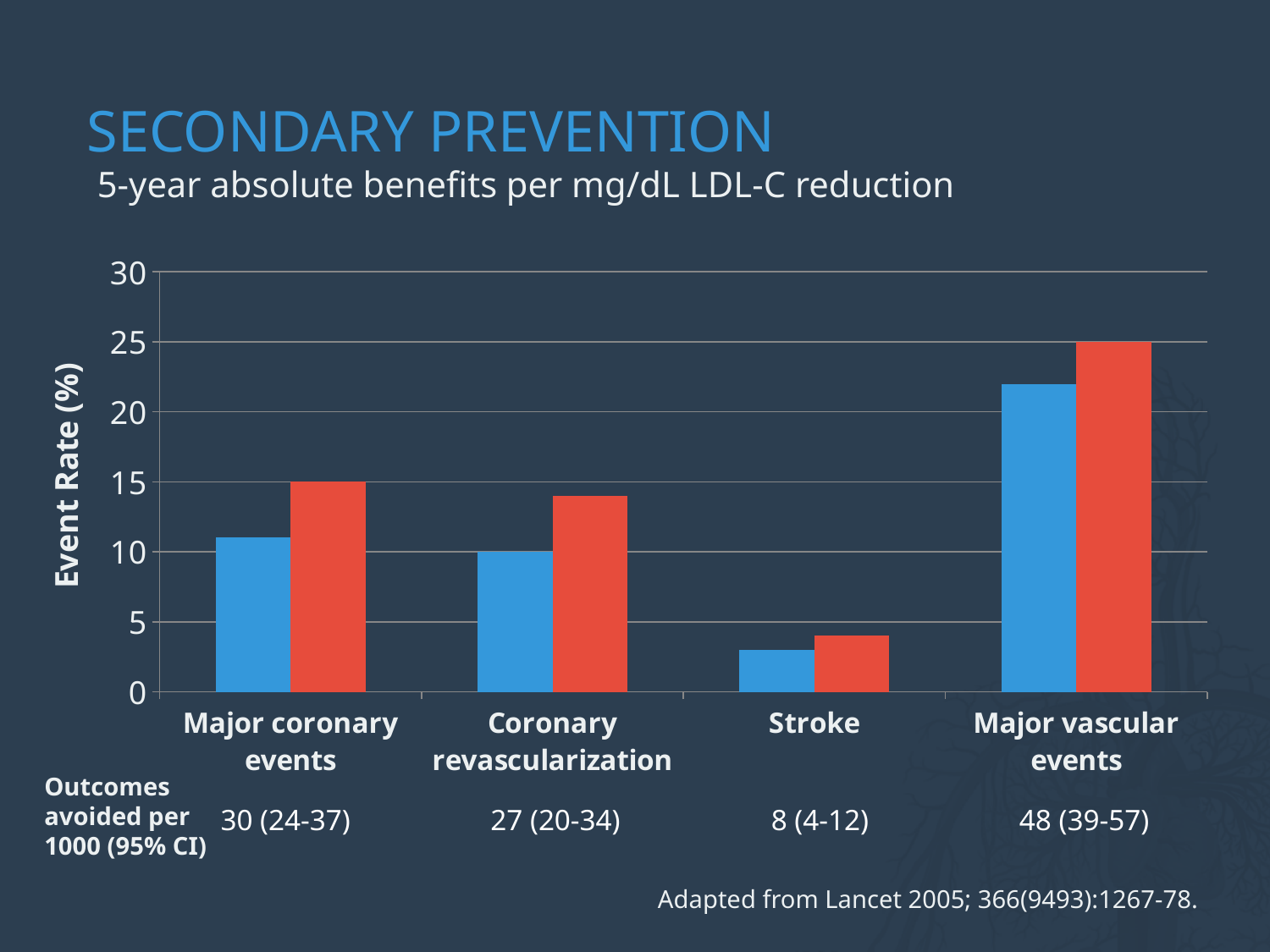
According to the row below the chart, how many outcomes are avoided per 1000 for Major vascular events? 48 (39-57) What is the value of the red bar for Major coronary events? 15 What is the y-axis label of the chart? Event Rate (%) What is the value of the red bar for Major vascular events? 25 Is the red bar for Stroke greater or less than 5? less Which category has the highest red bar? Major vascular events Is the blue bar for Major vascular events greater or less than 20? greater What kind of chart is shown on the slide? bar chart Which category has the lowest blue bar? Stroke How many outcome categories are shown on the x axis? 4 Which is larger for Coronary revascularization, the blue bar or the red bar? the red bar What is the value of the blue bar for Coronary revascularization? 10